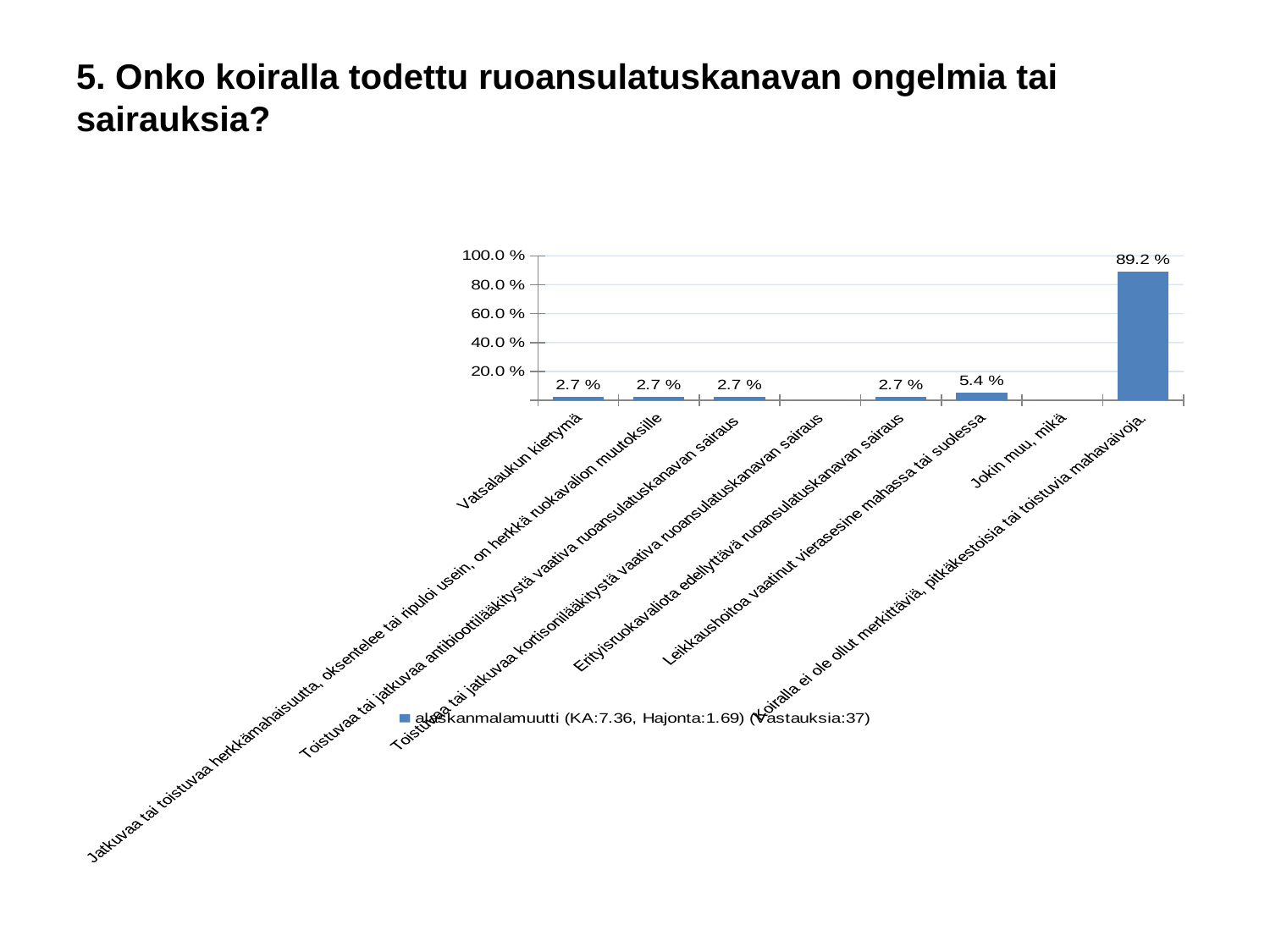
What is the difference between the value for "Leikkaushoitoa vaatinut vierasesine mahassa tai suolessa" and the value for "Vatsalaukun kiertymä"? 2.7 % Which category has the highest value? Koiralla ei ole ollut merkittäviä, pitkäkestoisia tai toistuvia mahavaivoja. Is the value for "Koiralla ei ole ollut merkittäviä, pitkäkestoisia tai toistuvia mahavaivoja." greater or less than 80.0 %? greater What kind of chart is shown on the slide? bar chart What is the value for "Leikkaushoitoa vaatinut vierasesine mahassa tai suolessa"? 5.4 % What is the difference between the value for "Koiralla ei ole ollut merkittäviä, pitkäkestoisia tai toistuvia mahavaivoja." and the value for "Leikkaushoitoa vaatinut vierasesine mahassa tai suolessa"? 83.8 % What is the value for "Koiralla ei ole ollut merkittäviä, pitkäkestoisia tai toistuvia mahavaivoja."? 89.2 % How many series does the legend list? 1 Which is larger: the value for "Leikkaushoitoa vaatinut vierasesine mahassa tai suolessa" or the value for "Vatsalaukun kiertymä"? Leikkaushoitoa vaatinut vierasesine mahassa tai suolessa What is the value for "Vatsalaukun kiertymä"? 2.7 % What is the value for "Erityisruokavaliota edellyttävä ruoansulatuskanavan sairaus"? 2.7 % How many categories are shown on the x axis of the chart? 8